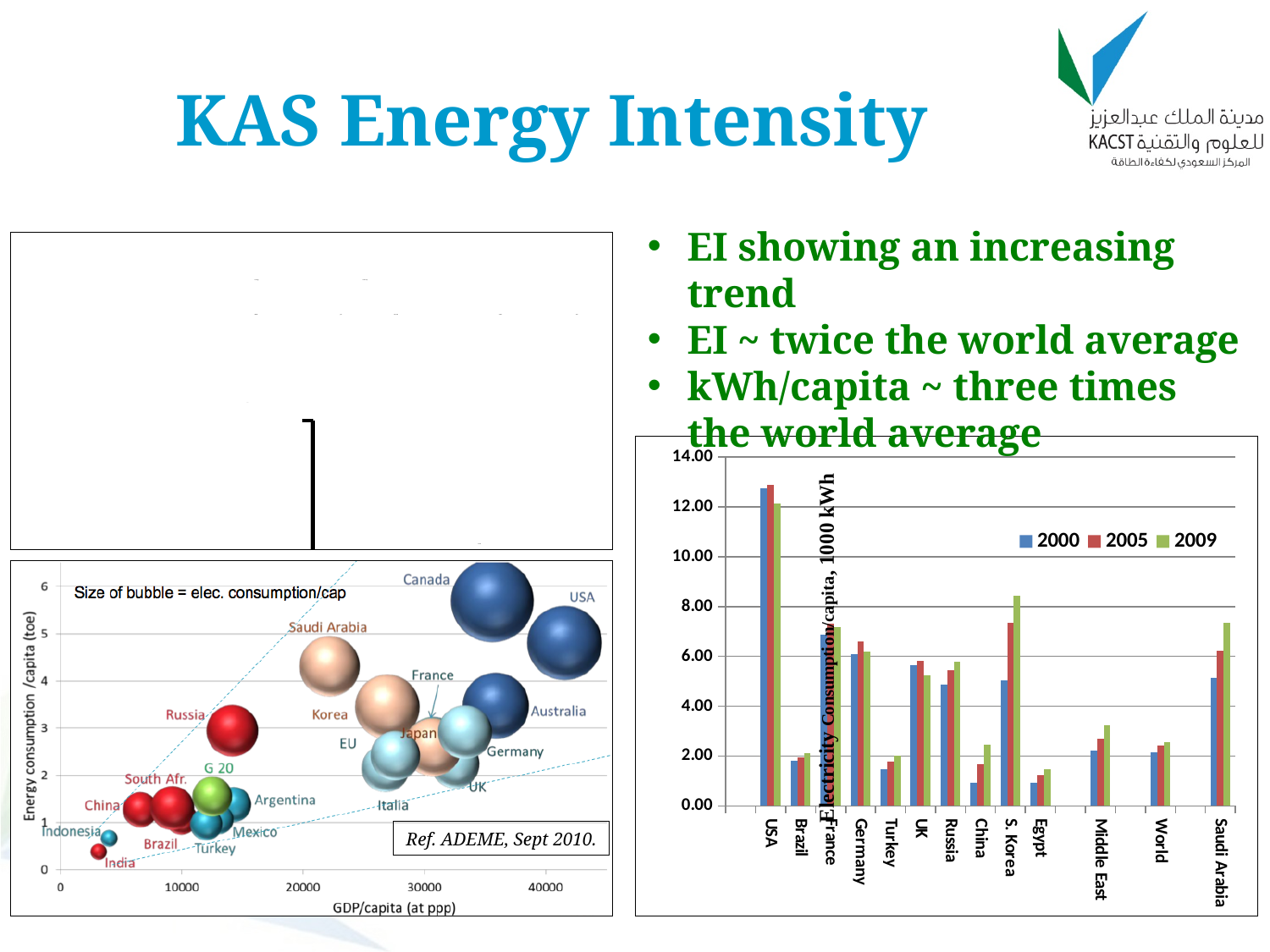
What type of chart is the chart on the right of the slide? bar chart In the bubble chart at the bottom left, what does the size of each bubble represent? elec. consumption/cap In the bar chart on the right, is the 2000 value for USA greater or less than 12.00? greater In the bar chart on the right, which country has the highest electricity consumption per capita? USA In the bar chart on the right, how many series does the legend list? 3 In the bar chart on the right, how many countries or regions are shown on the x axis? 13 In the bar chart on the right, do the values for Saudi Arabia rise or fall from 2000 to 2009? rise In the bubble chart at the bottom left, which country has the lowest energy consumption per capita? India In the bar chart on the right, is the 2000 value for China greater or less than 2.00? less In the bar chart on the right, which has the larger 2009 value, France or UK? France In the bar chart on the right, which has the larger 2009 value, Saudi Arabia or Germany? Saudi Arabia In the bar chart on the right, is the 2009 value for Saudi Arabia greater or less than 6.00? greater